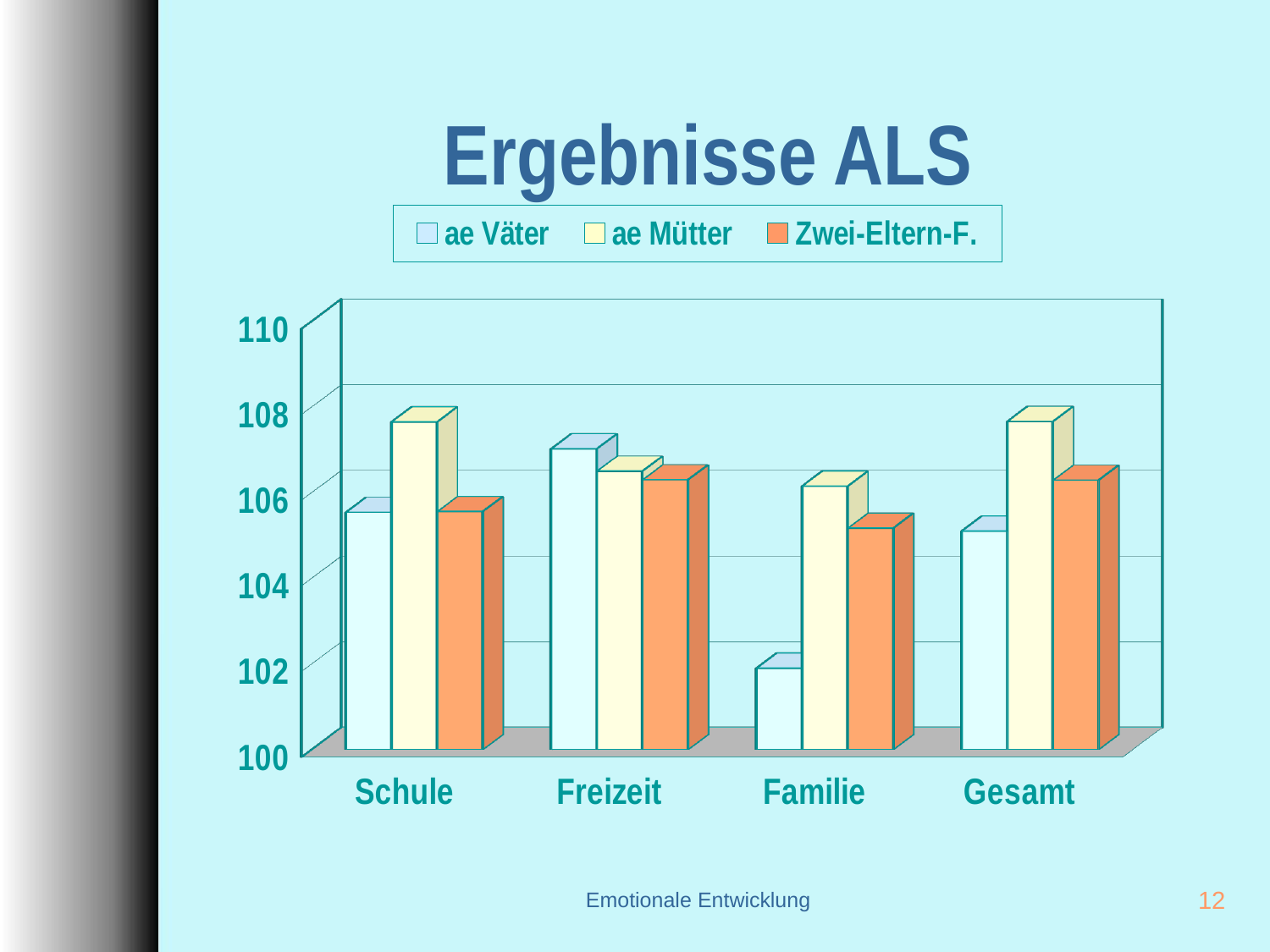
For the ae Väter series, which category has the lowest value? Familie In the Familie category, which is larger: ae Väter or ae Mütter? ae Mütter Is the value for ae Väter in the Familie category greater or less than 104? less Is the value for ae Mütter in the Schule category greater or less than 106? greater Which series is shown in orange in the legend? Zwei-Eltern-F. Is the value for Zwei-Eltern-F. in the Familie category greater or less than 104? greater In the Familie category, which series has the lowest value? ae Väter How many categories are shown on the x axis? 4 What kind of chart is shown on the slide? bar chart How many series does the legend list? 3 What is the title of the chart? Ergebnisse ALS